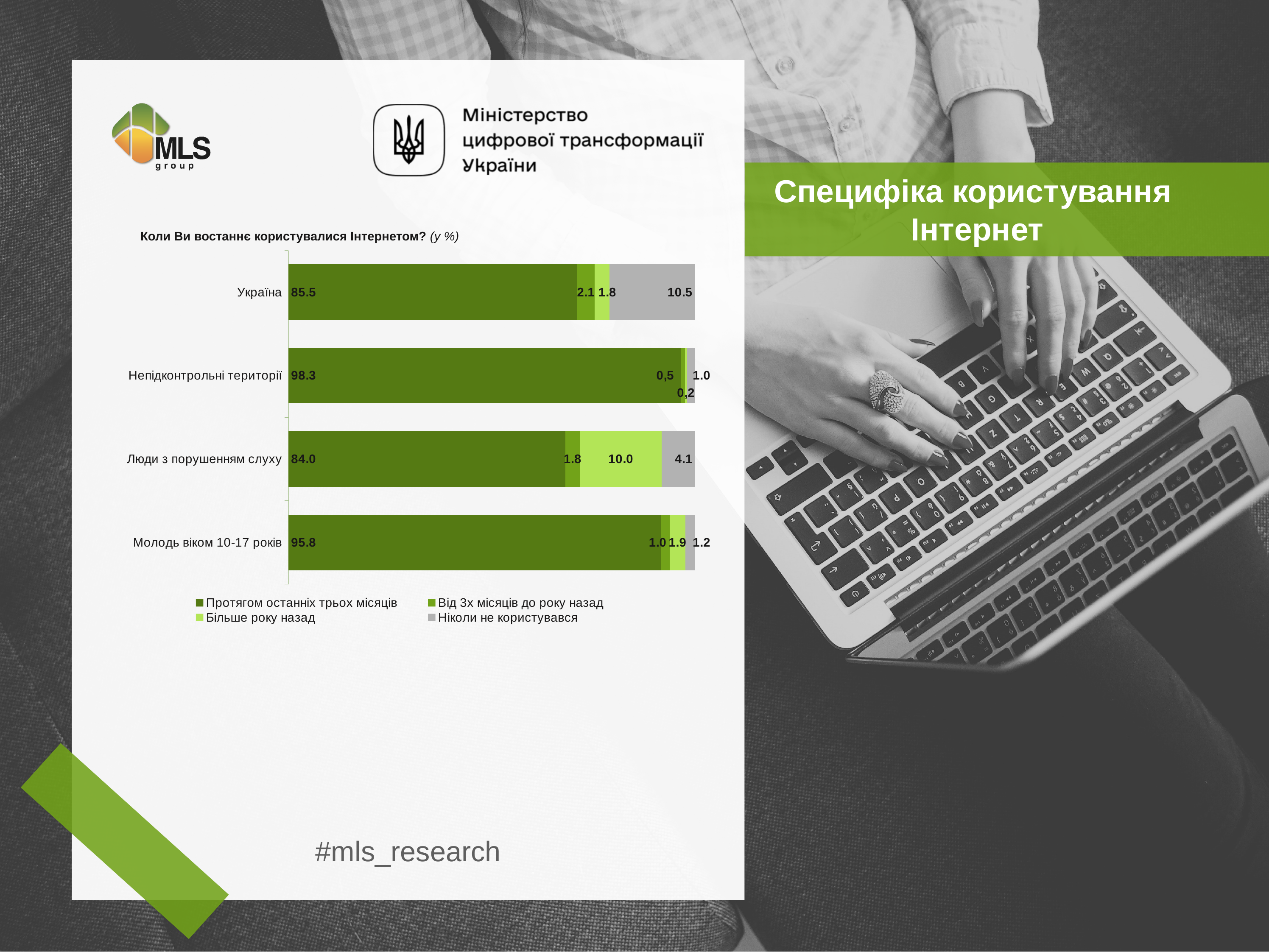
What is the difference between the 'Ніколи не користувався' values for Україна and Люди з порушенням слуху? 6.4 What is the value of 'Ніколи не користувався' for Молодь віком 10-17 років? 1.2 What is the value of 'Більше року назад' for Люди з порушенням слуху? 10.0 Which category has the highest value for 'Протягом останніх трьох місяців'? Непідконтрольні території What is the value of 'Протягом останніх трьох місяців' for Україна? 85.5 What kind of chart is shown on the slide? Stacked bar chart Which category has the lowest value for 'Протягом останніх трьох місяців'? Люди з порушенням слуху How many categories are plotted on the chart? 4 What is the value of 'Ніколи не користувався' for Україна? 10.5 How many series does the legend list? 4 What is the value of 'Протягом останніх трьох місяців' for Непідконтрольні території? 98.3 Which is larger: the 'Більше року назад' value for Україна or for Молодь віком 10-17 років? Молодь віком 10-17 років